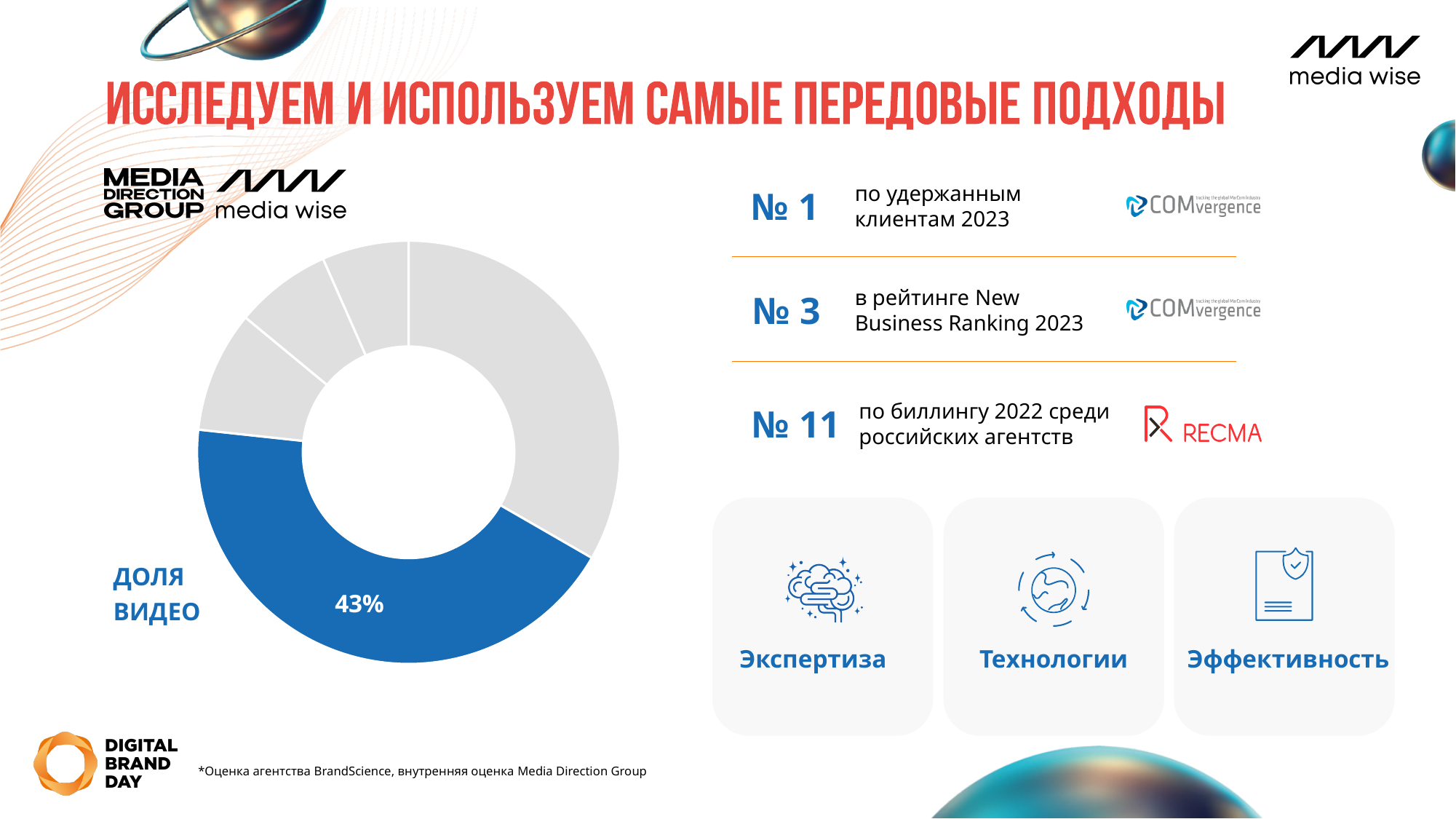
Is the video share (ДОЛЯ ВИДЕО) in the donut chart greater or less than 25%? greater Which is larger in the donut chart: the blue video slice or the largest grey slice? The blue video slice Is the video share (ДОЛЯ ВИДЕО) in the donut chart greater or less than 50%? less Which slice of the donut chart is the largest? ДОЛЯ ВИДЕО (43%) What colour is the slice labelled ДОЛЯ ВИДЕО in the donut chart? Blue What is the only data label printed on the donut chart? 43% What share of the donut chart is labelled as the video share (ДОЛЯ ВИДЕО)? 43% What kind of chart is shown on the slide? Donut (pie) chart